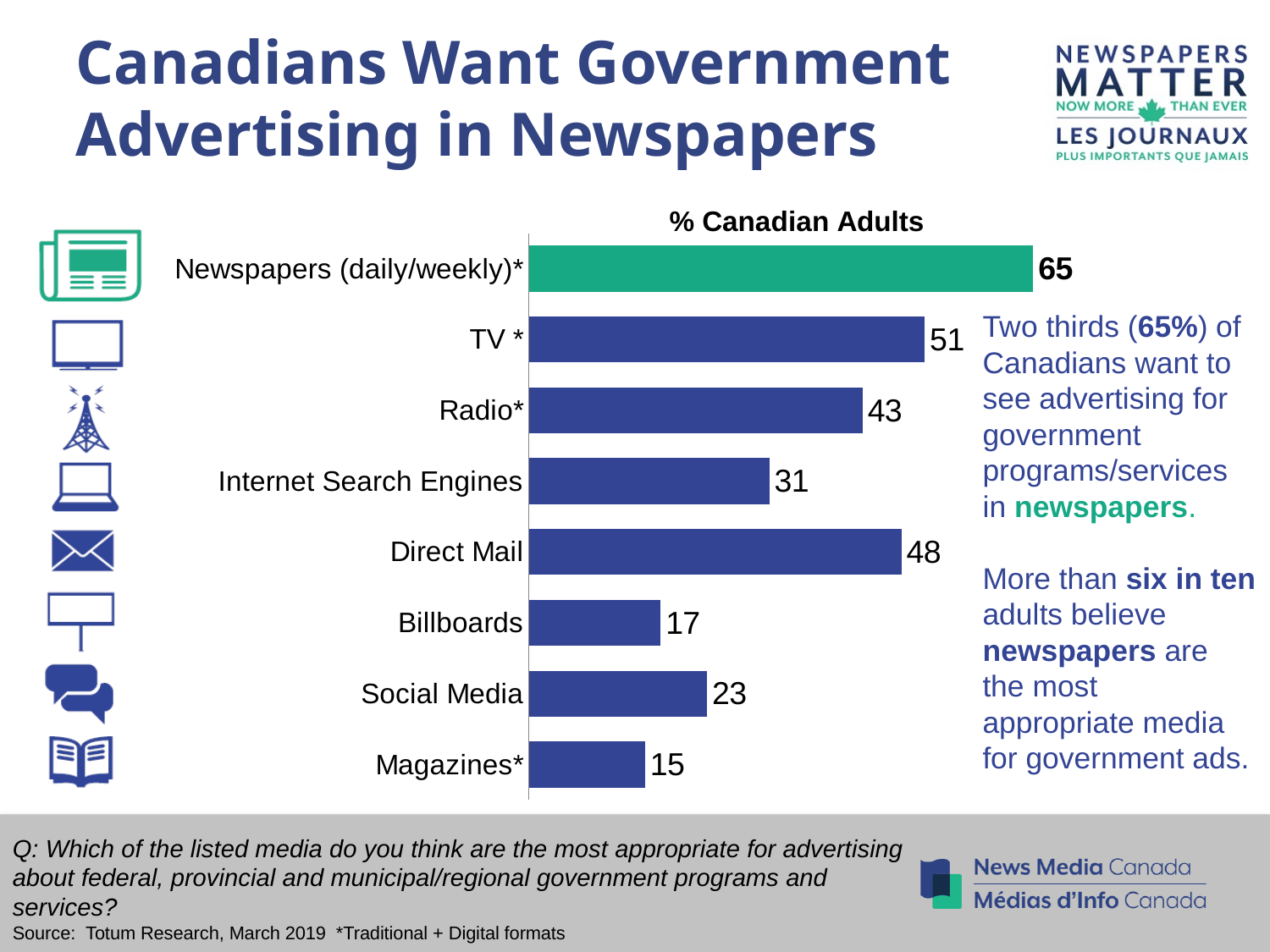
Which is larger, the value for Internet Search Engines or the value for Social Media? Internet Search Engines Which is larger, the value for Billboards or the value for Magazines*? Billboards What is the difference between the values for TV * and Radio*? 8 What is the value for Newspapers (daily/weekly)*? 65 What is the value for Direct Mail? 48 Which category has the highest value? Newspapers (daily/weekly)* What is the title of the chart? % Canadian Adults What is the difference between the values for Newspapers (daily/weekly)* and Direct Mail? 17 Which category has the lowest value? Magazines* What kind of chart is shown on the slide? Bar chart What is the value for Social Media? 23 How many categories are shown in the chart? 8